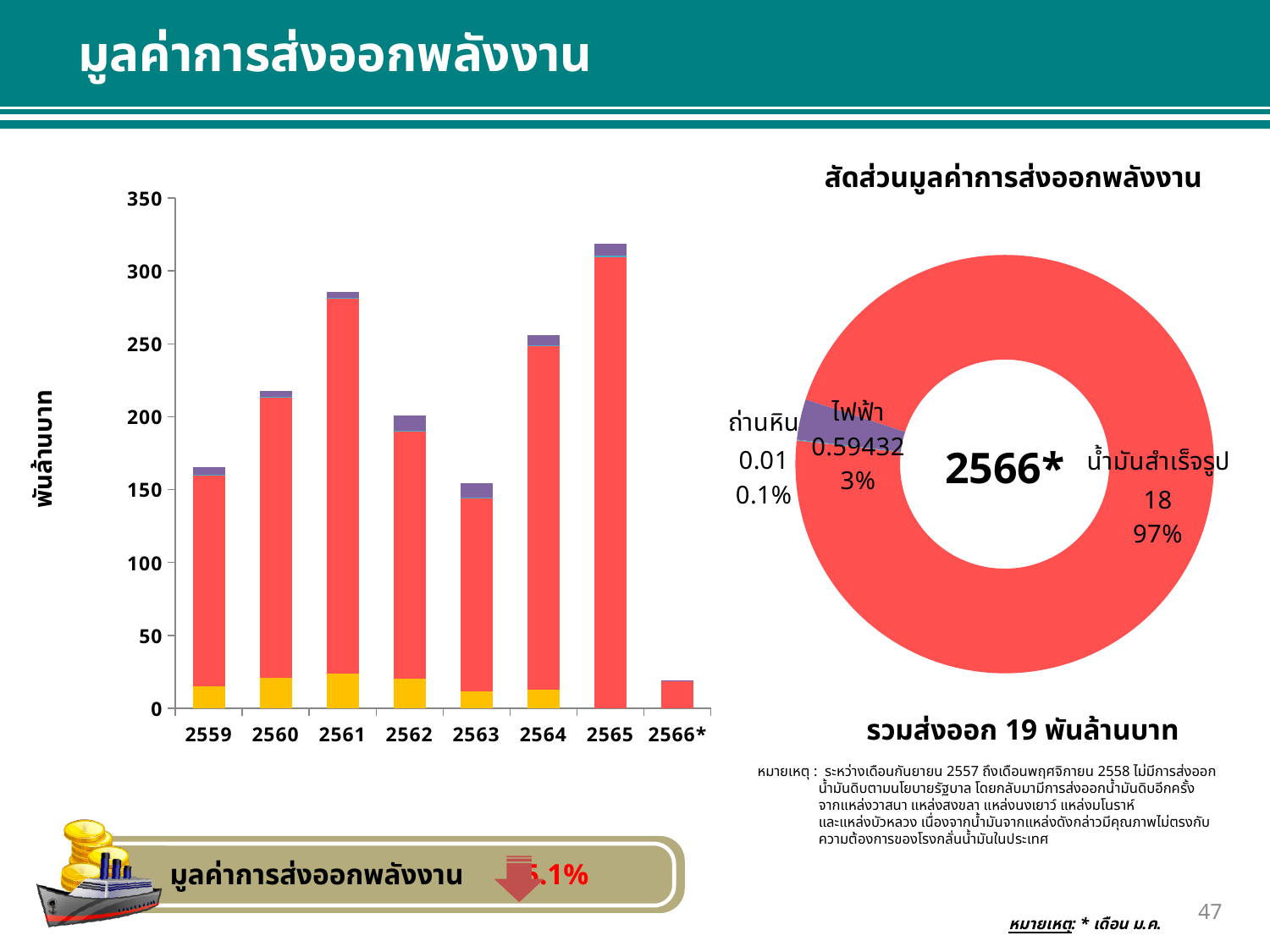
In the bar chart on the left, which year has the tallest bar? 2565 In the bar chart on the left, is the total bar for 2565 greater or less than 300? greater What type of chart is the chart on the left side of the slide? bar chart In the chart titled สัดส่วนมูลค่าการส่งออกพลังงาน, what is the value shown for ไฟฟ้า? 0.59432 In the bar chart on the left, which year has the shortest bar? 2566* In the bar chart on the left, do the bar totals rise or fall from 2563 to 2565? rise In the bar chart on the left, which year has a taller bar, 2560 or 2561? 2561 In the bar chart on the left, is the total bar for 2561 greater or less than 250? greater In the bar chart on the left, is the total bar for 2566* greater or less than 50? less In the chart titled สัดส่วนมูลค่าการส่งออกพลังงาน, what share does น้ำมันสำเร็จรูป have? 97% In the bar chart on the left, how many years are shown on the x axis? 8 In the chart titled สัดส่วนมูลค่าการส่งออกพลังงาน, which category has the smallest share? ถ่านหิน